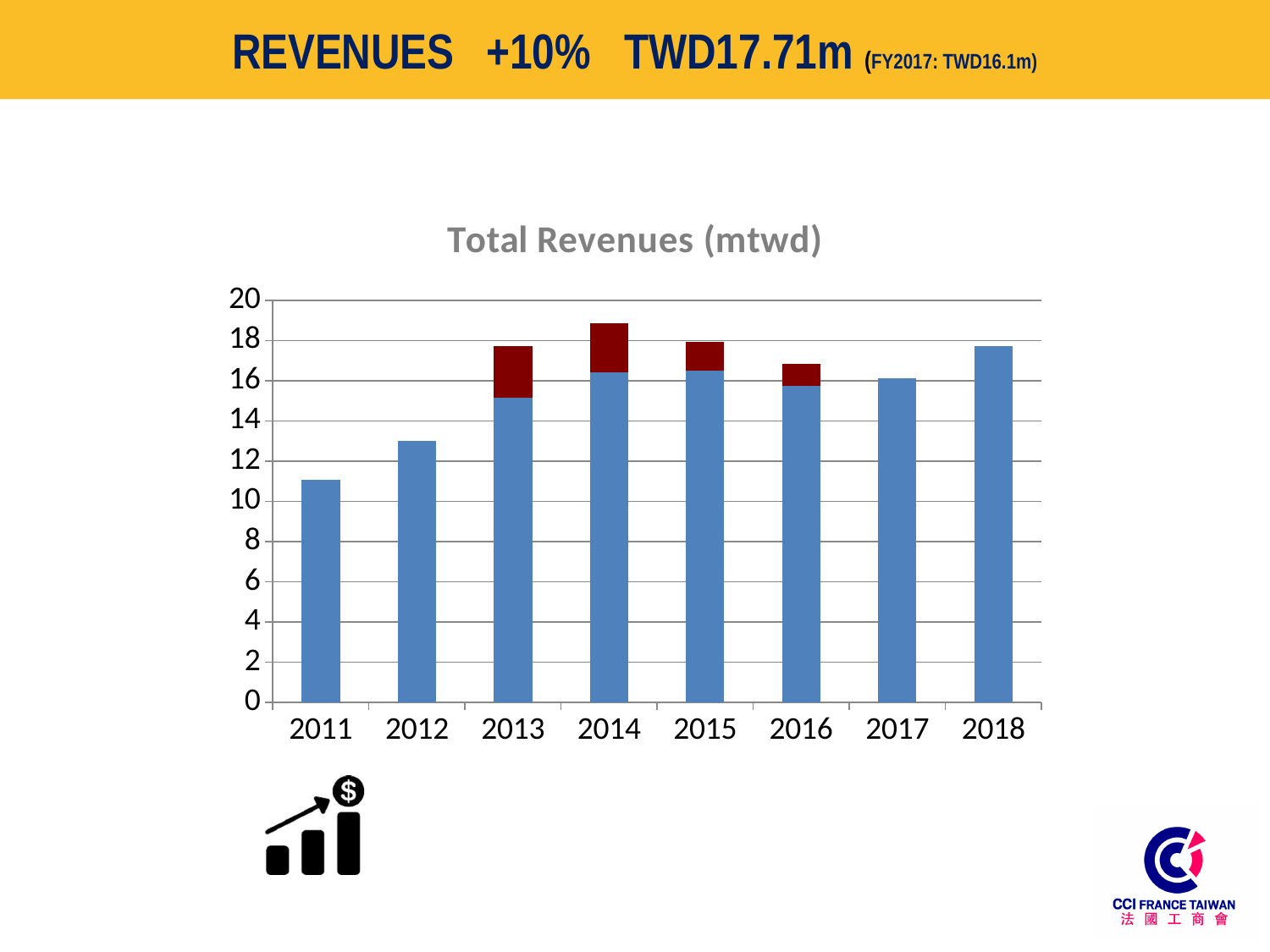
Is the value for 2012 greater or less than 12? greater How many years are shown on the x axis of the chart? 8 What kind of chart is shown on the slide? bar chart Which year has the lowest bar in the chart? 2011 Is the value for 2018 greater or less than 16? greater Is the value for 2011 greater or less than 12? less Which is larger, the bar for 2017 or the bar for 2018? 2018 What is the title of the chart? Total Revenues (mtwd) Which year has the highest total bar in the chart? 2014 Which years have a dark red segment on top of the blue bar? 2013, 2014, 2015, 2016 Do the bars rise or fall from 2011 to 2014? rise